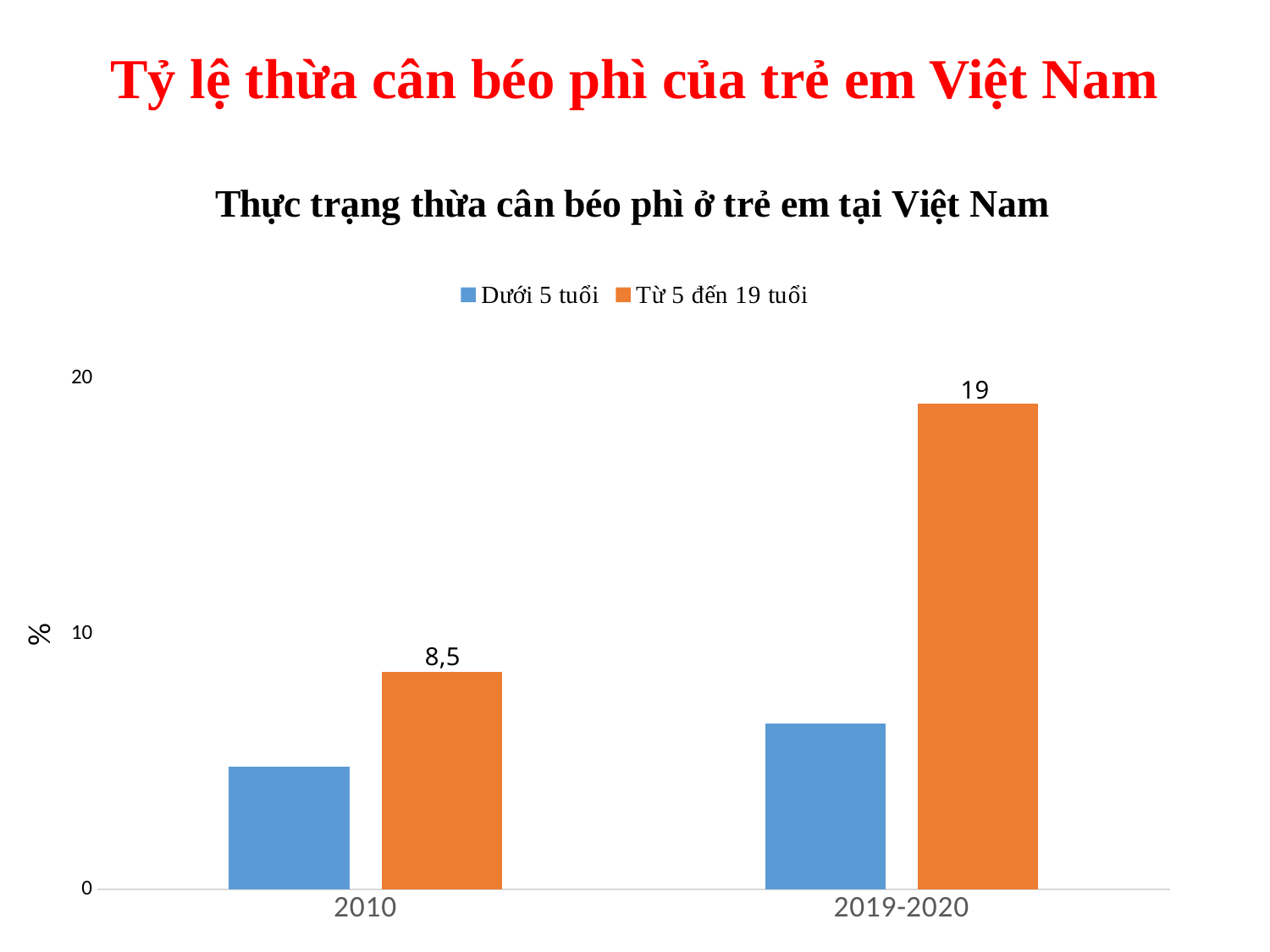
What kind of chart is shown on the slide? bar chart What is the difference between the Từ 5 đến 19 tuổi values for 2019-2020 and 2010? 10,5 What is the value for Từ 5 đến 19 tuổi in 2019-2020? 19 How many series does the legend list? 2 For Từ 5 đến 19 tuổi, which period has the larger value, 2010 or 2019-2020? 2019-2020 In 2019-2020, which series has the higher value, Dưới 5 tuổi or Từ 5 đến 19 tuổi? Từ 5 đến 19 tuổi How many categories are shown on the x axis? 2 Is the value for Dưới 5 tuổi in 2010 greater or less than 10? less What is the value for Từ 5 đến 19 tuổi in 2010? 8,5 Which bar is the highest in the chart? Từ 5 đến 19 tuổi in 2019-2020 Do the values for Từ 5 đến 19 tuổi rise or fall from 2010 to 2019-2020? rise Is the value for Dưới 5 tuổi in 2019-2020 greater or less than 10? less